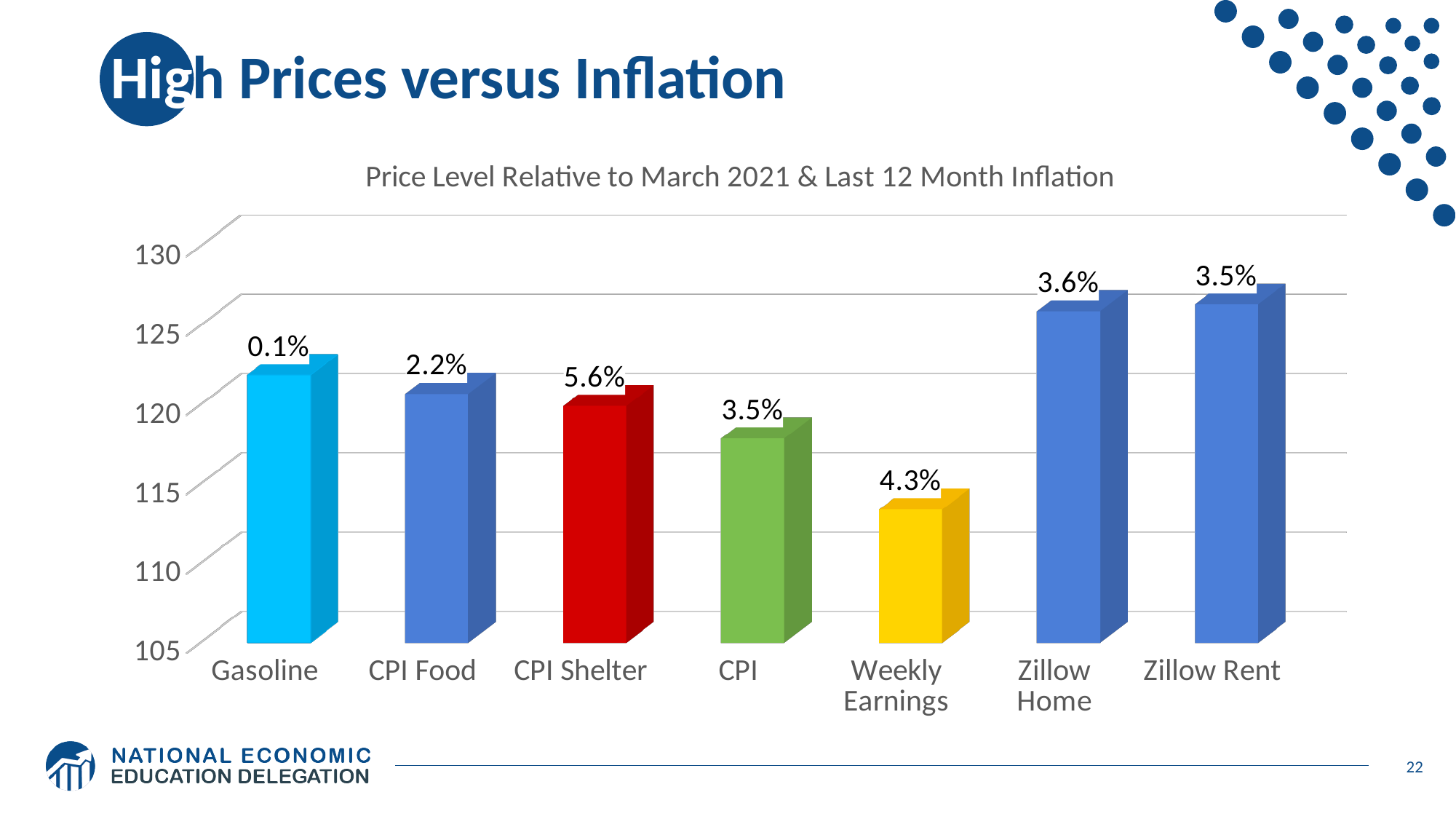
What percentage label is printed above the Gasoline bar? 0.1% What percentage label is printed above the Zillow Home bar? 3.6% What is the title of the chart? Price Level Relative to March 2021 & Last 12 Month Inflation What percentage label is printed above the CPI Shelter bar? 5.6% What percentage label is printed above the Weekly Earnings bar? 4.3% Which category has the highest percentage label printed above its bar? CPI Shelter Is the bar height for Weekly Earnings greater or less than 115? less Is the bar height for Zillow Home greater or less than 125? greater Which category has the lowest percentage label printed above its bar? Gasoline Which category has the shortest bar in the chart? Weekly Earnings How many categories are shown on the x axis of the chart? 7 What kind of chart is shown on the slide? bar chart